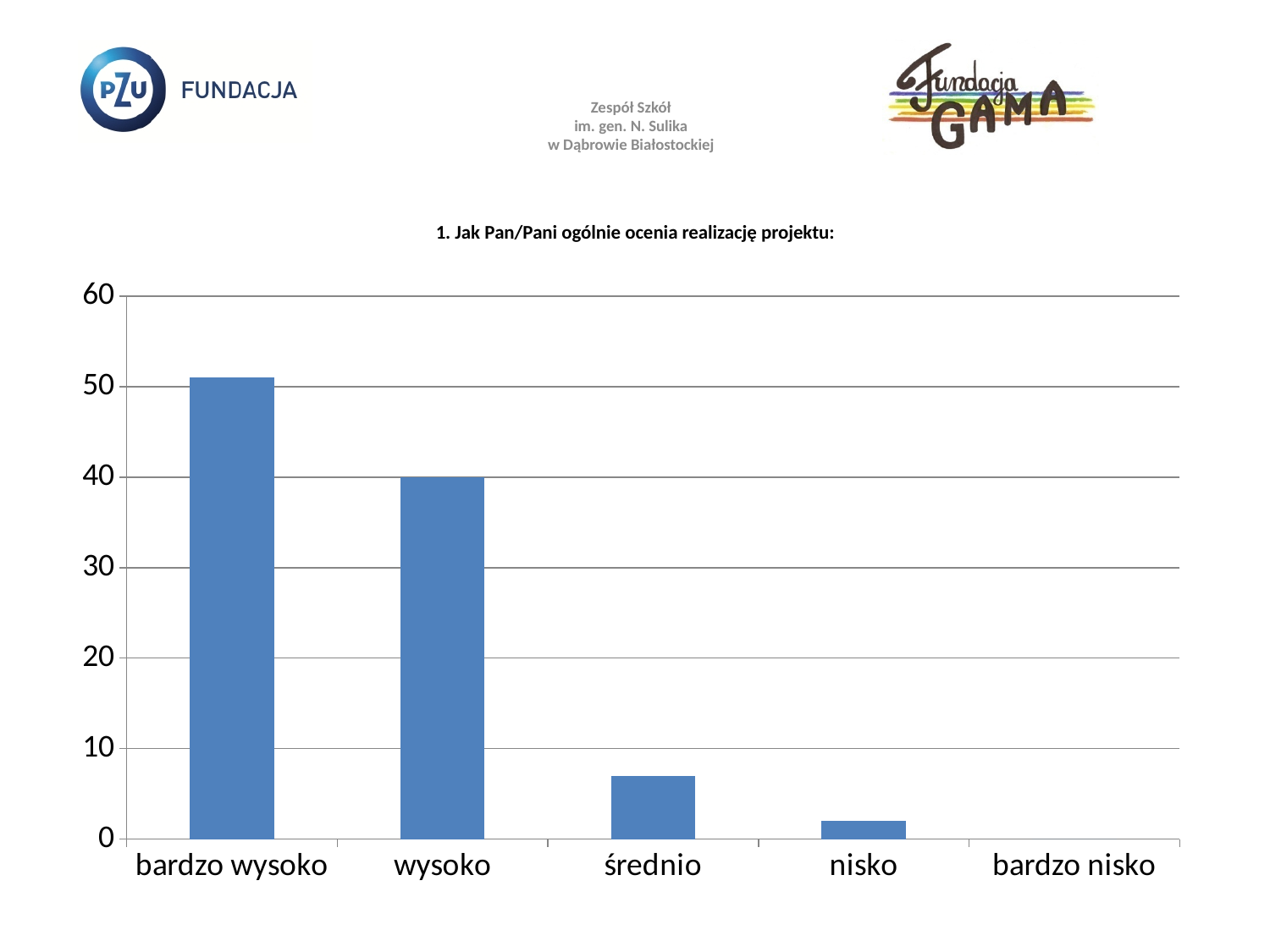
Is the value for "nisko" greater or less than 10? less Which category has the highest value in the chart? bardzo wysoko What is the title of the chart? 1. Jak Pan/Pani ogólnie ocenia realizację projektu: What kind of chart is shown on the slide? bar chart Which category has the lowest value in the chart? bardzo nisko Is the value for "bardzo wysoko" greater or less than 50? greater Which is larger, the value for "bardzo wysoko" or the value for "wysoko"? bardzo wysoko What is the value for "wysoko" in the chart? 40 What is the value for "bardzo nisko" in the chart? 0 How many categories are shown on the x axis of the chart? 5 Is the value for "średnio" greater or less than 10? less Do the values rise or fall moving from left to right along the x axis? fall